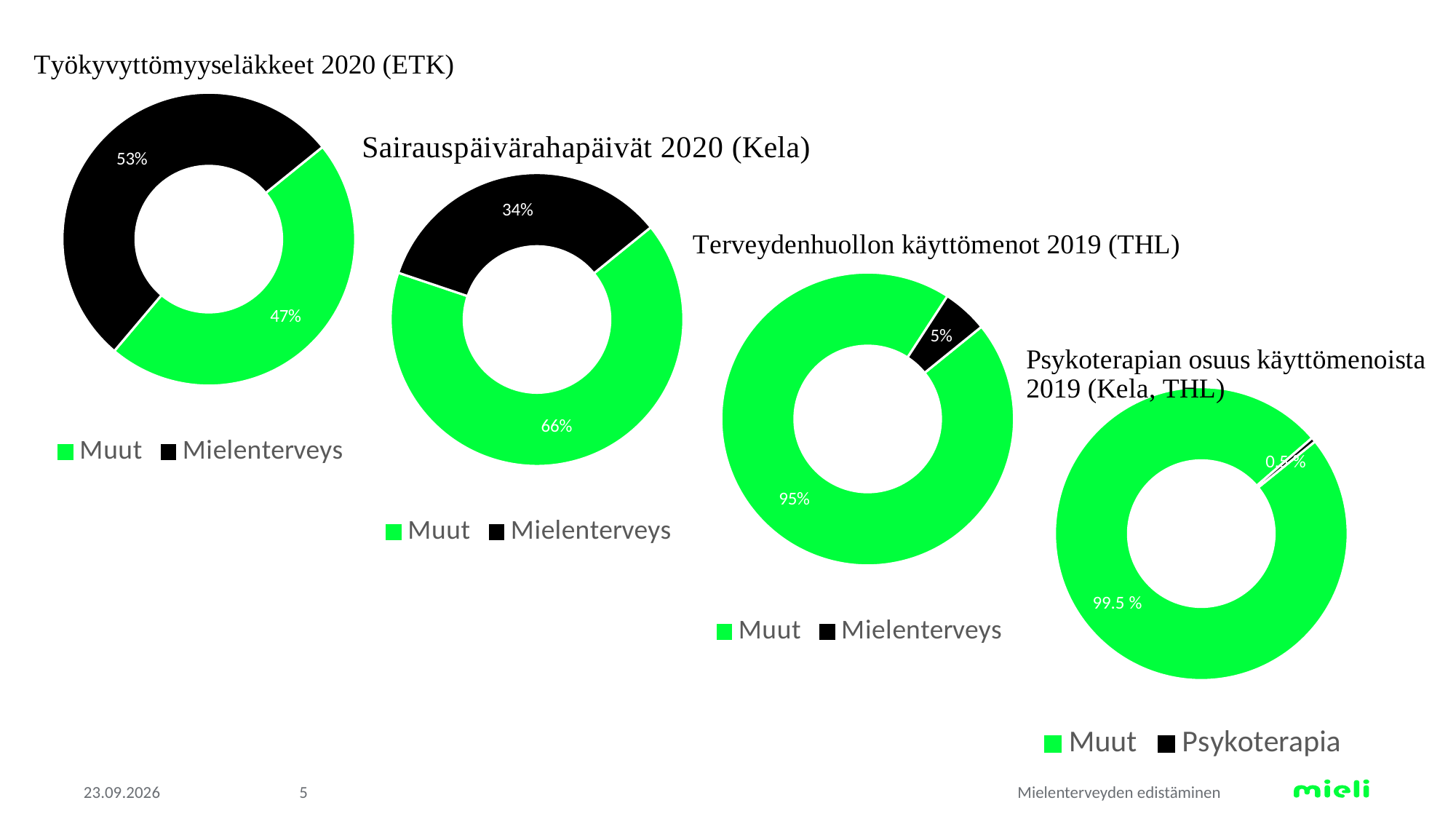
How many series does the legend of the chart titled 'Psykoterapian osuus käyttömenoista 2019 (Kela, THL)' list? 2 What kind of chart is used for 'Sairauspäivärahapäivät 2020 (Kela)'? Doughnut chart In the chart titled 'Terveydenhuollon käyttömenot 2019 (THL)', what share is labelled for Mielenterveys? 5% In the chart titled 'Sairauspäivärahapäivät 2020 (Kela)', what share is labelled for Mielenterveys? 34% In the chart titled 'Psykoterapian osuus käyttömenoista 2019 (Kela, THL)', what are the two legend entries? Muut and Psykoterapia In the chart titled 'Terveydenhuollon käyttömenot 2019 (THL)', which slice is the largest? Muut In the chart titled 'Sairauspäivärahapäivät 2020 (Kela)', what share is labelled for Muut? 66% In the chart titled 'Työkyvyttömyyseläkkeet 2020 (ETK)', what share is labelled for Mielenterveys? 53% In the chart titled 'Työkyvyttömyyseläkkeet 2020 (ETK)', which slice is larger, Muut or Mielenterveys? Mielenterveys In the chart titled 'Työkyvyttömyyseläkkeet 2020 (ETK)', what share is labelled for Muut? 47% In the chart titled 'Sairauspäivärahapäivät 2020 (Kela)', what is the difference in percentage points between Muut and Mielenterveys? 32 In the chart titled 'Psykoterapian osuus käyttömenoista 2019 (Kela, THL)', what share is labelled for Muut? 99.5 %